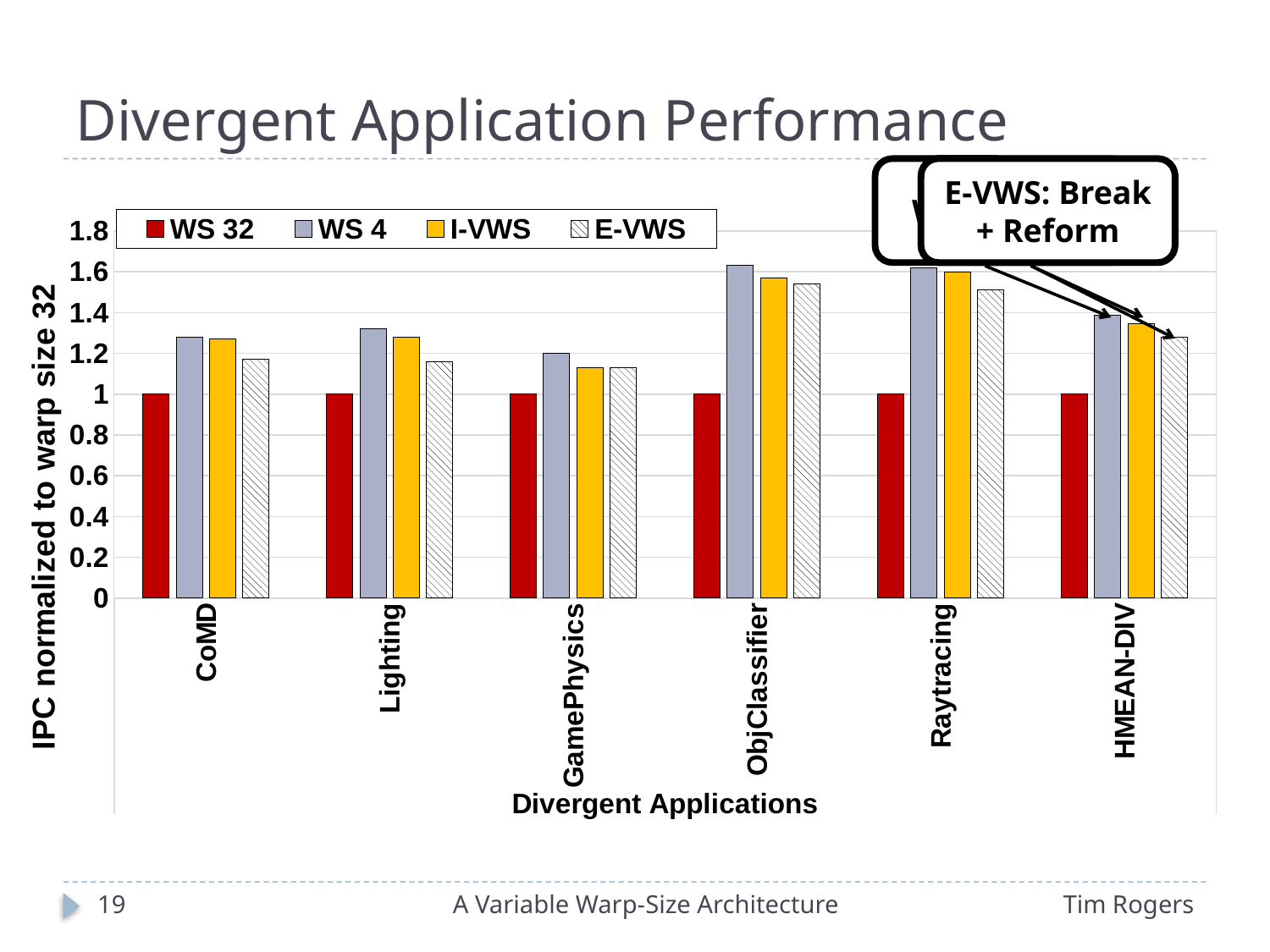
Is the E-VWS value for CoMD greater or less than 1.2? less What kind of chart is shown on the slide? bar chart How many application categories are shown on the x axis? 6 Which application has the lowest WS 4 value? GamePhysics What is the value of the WS 32 bar for HMEAN-DIV? 1 For Lighting, which is larger: the WS 4 value or the E-VWS value? WS 4 What is the value of the WS 32 bar for CoMD? 1 What is the title of the y axis? IPC normalized to warp size 32 Is the E-VWS value for Raytracing greater or less than 1.6? less Is the I-VWS value for GamePhysics greater or less than 1.2? less How many series does the legend list? 4